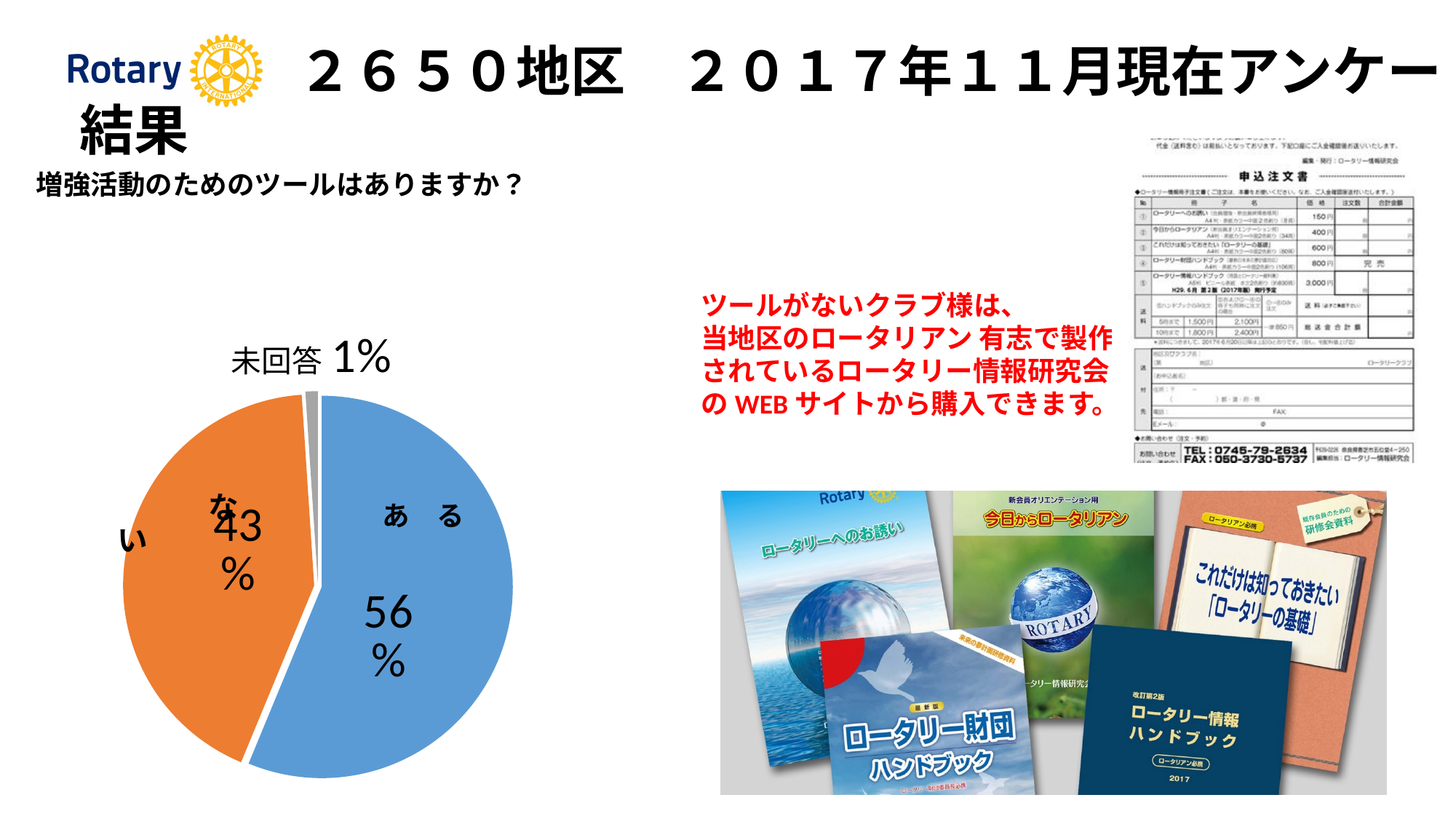
What is the difference in percentage points between the ある slice and the ない slice? 13 What percentage of the pie chart is the ある (yes) slice? 56% Which slice of the pie chart is the largest? ある What survey question does the pie chart answer, as written above it? 増強活動のためのツールはありますか？ Which is larger in the pie chart, ある or ない? ある Which slice of the pie chart is the smallest? 未回答 How many slices does the pie chart have? 3 What percentage of the pie chart is the 未回答 (no answer) slice? 1% What kind of chart is shown on the slide? pie chart What colour is the ある slice in the pie chart? blue What percentage of the pie chart is the ない (no) slice? 43% What is the combined share of the ない and 未回答 slices? 44%